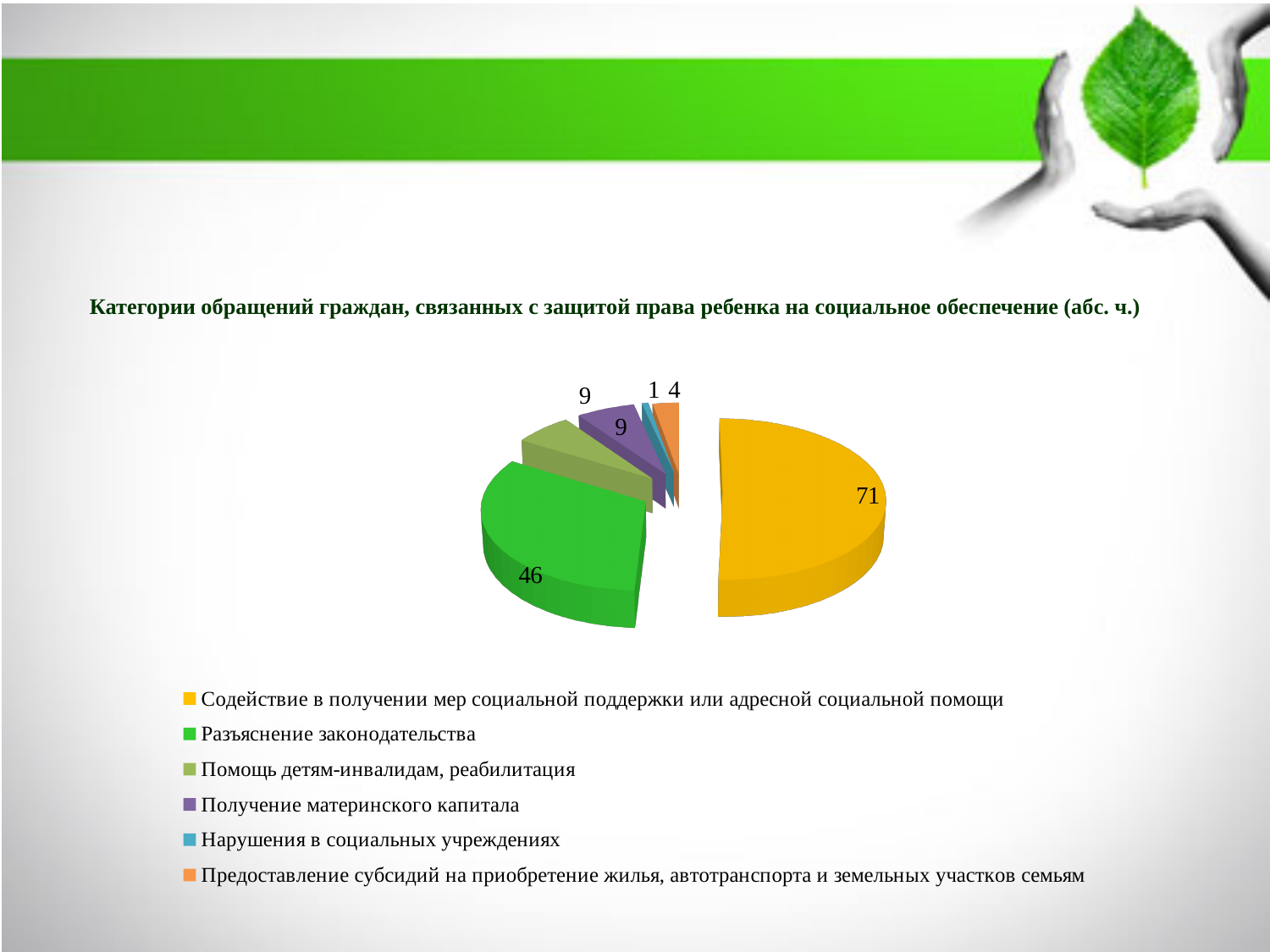
What type of chart is shown on the slide? Pie chart Which category has the smallest slice of the pie? Нарушения в социальных учреждениях What is the value for "Разъяснение законодательства"? 46 What is the value for "Нарушения в социальных учреждениях"? 1 What is the difference between the values for "Содействие в получении мер социальной поддержки или адресной социальной помощи" and "Разъяснение законодательства"? 25 What is the total of all the values shown in the pie chart? 140 Which category has the largest slice of the pie? Содействие в получении мер социальной поддержки или адресной социальной помощи What is the value for "Предоставление субсидий на приобретение жилья, автотранспорта и земельных участков семьям"? 4 What is the value for "Содействие в получении мер социальной поддержки или адресной социальной помощи"? 71 Which is larger: the value for "Получение материнского капитала" or the value for "Предоставление субсидий на приобретение жилья, автотранспорта и земельных участков семьям"? Получение материнского капитала What colour is the slice for "Разъяснение законодательства"? Green How many categories does the pie chart have? 6